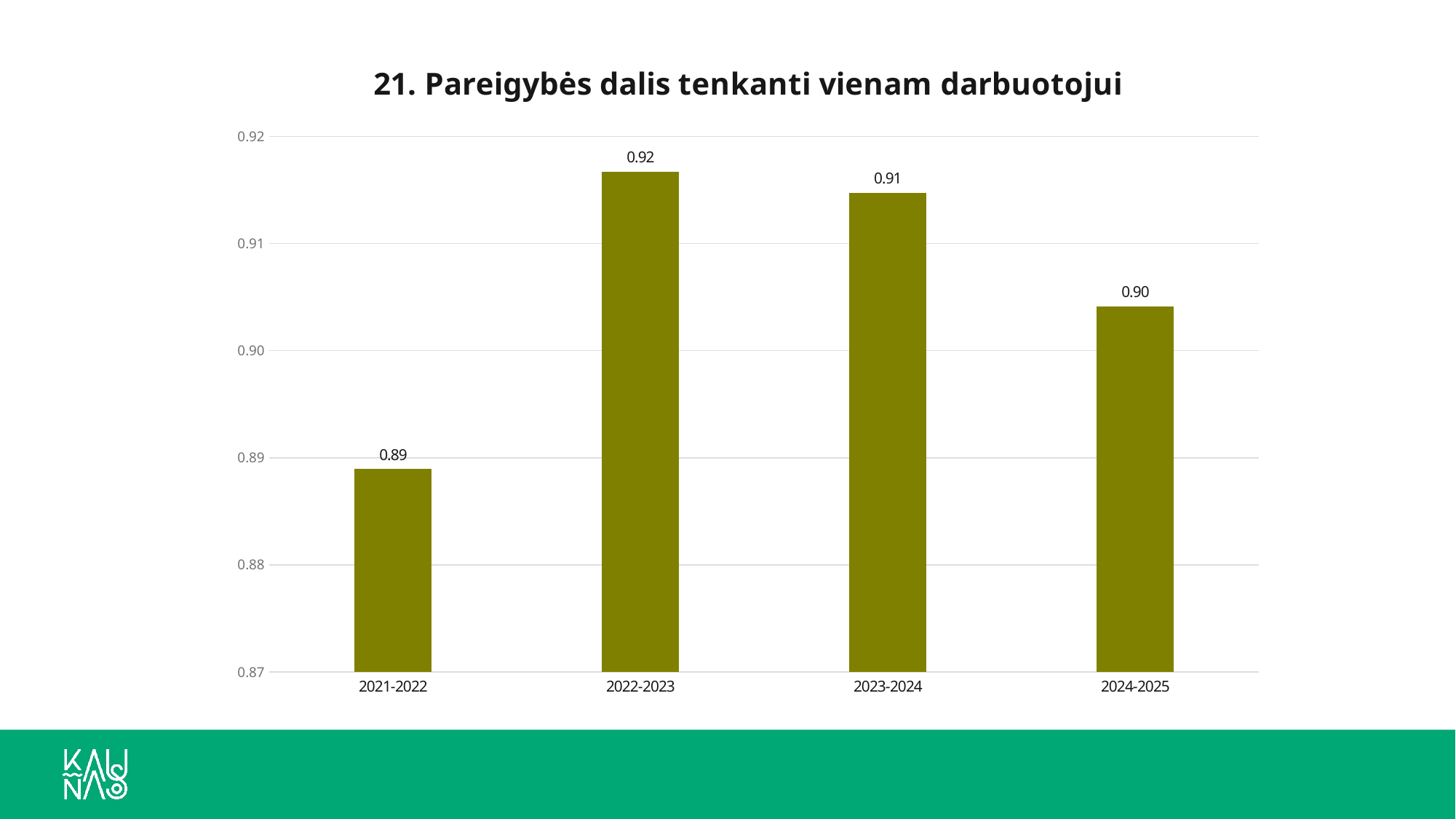
How many periods are shown on the x axis? 4 What is the title of the chart? 21. Pareigybės dalis tenkanti vienam darbuotojui Which is larger, the value for 2023-2024 or the value for 2024-2025? 2023-2024 What is the value for 2024-2025? 0.90 What is the value for 2023-2024? 0.91 What kind of chart is shown on the slide? bar chart Is the value for 2021-2022 greater or less than 0.90? less Which period has the lowest value? 2021-2022 Which period has the highest value? 2022-2023 What is the value for 2021-2022? 0.89 What is the difference between the values for 2022-2023 and 2021-2022? 0.03 What is the value for 2022-2023? 0.92